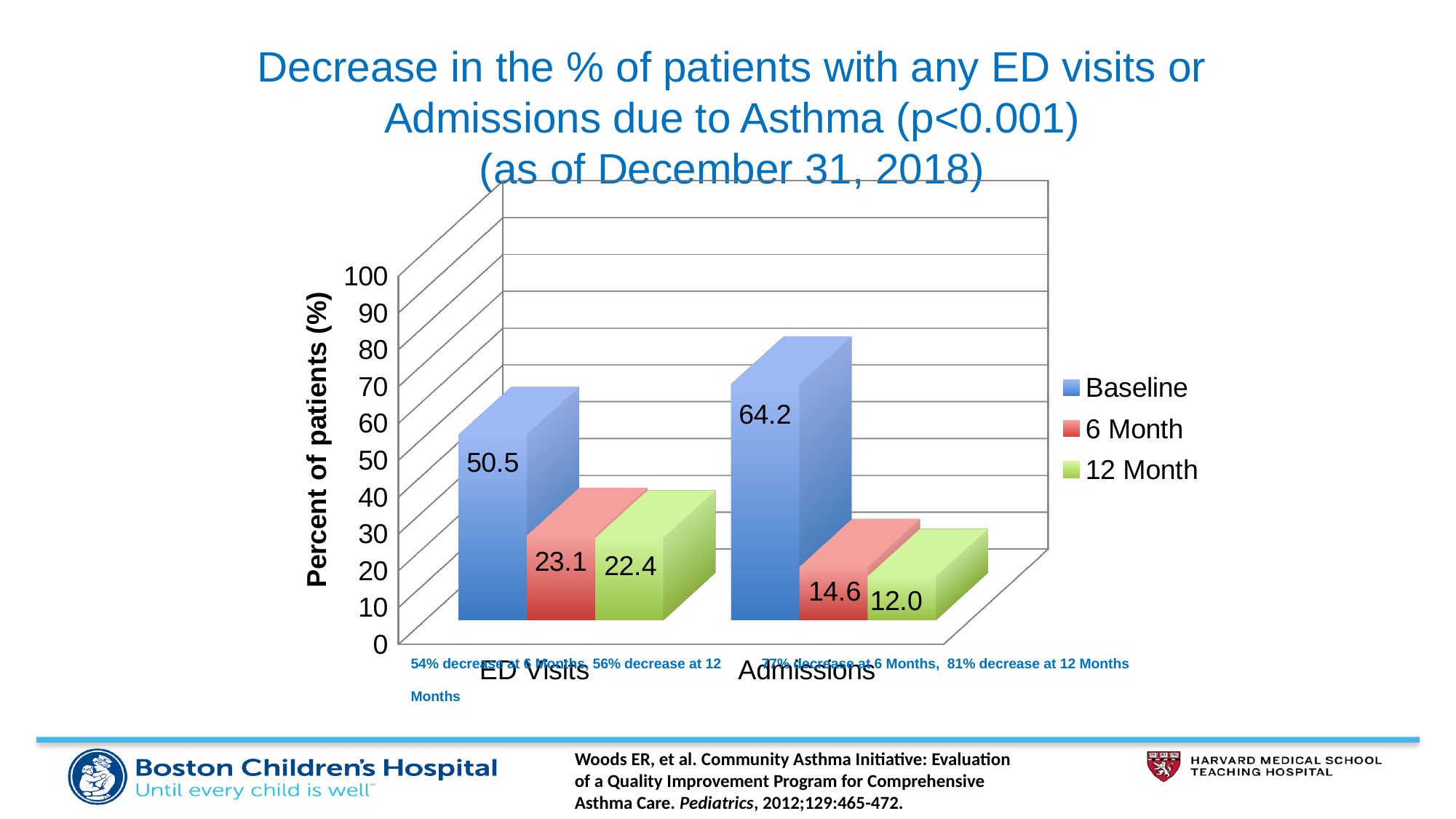
How many series does the legend list? 3 Which category has the higher Baseline value, ED Visits or Admissions? Admissions Which series has the lowest value for Admissions? 12 Month What is the Baseline value for ED Visits? 50.5 How many categories are shown on the x axis? 2 What is the difference between the 6 Month values for ED Visits and Admissions? 8.5 What is the 12 Month value for Admissions? 12.0 Do the values for Admissions rise or fall from Baseline to 12 Month? Fall What is the 6 Month value for ED Visits? 23.1 What is the difference between the Baseline and 12 Month values for Admissions? 52.2 What is the label of the y axis? Percent of patients (%) What kind of chart is shown on the slide? Bar chart